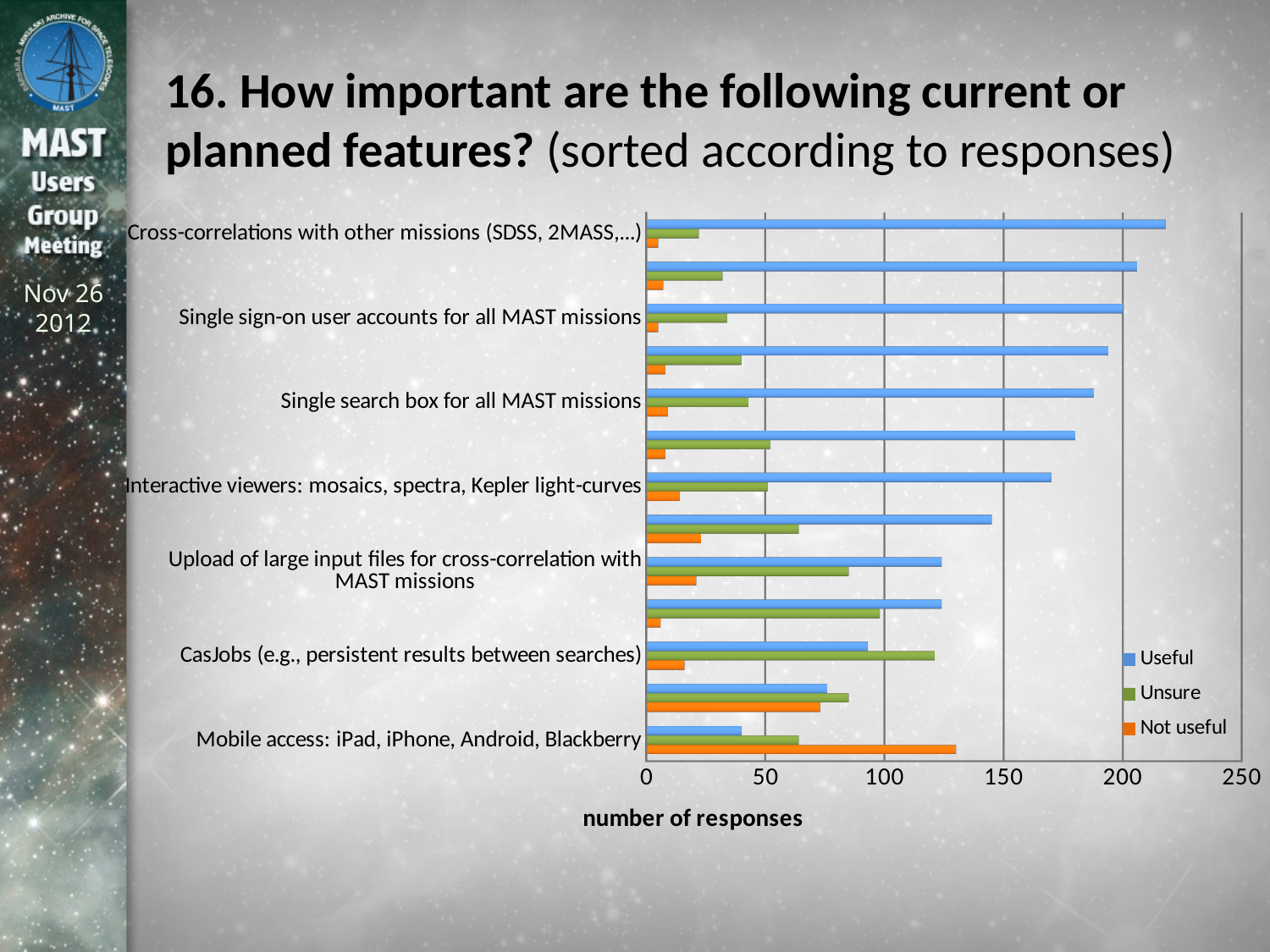
Is the 'Useful' value for Cross-correlations with other missions greater or less than 200? greater Which has more 'Useful' responses: Single search box for all MAST missions or CasJobs? Single search box for all MAST missions Is the 'Useful' value for Mobile access greater or less than 50? less What kind of chart is shown on the slide? bar chart Which labelled feature has the lowest number of 'Useful' responses? Mobile access: iPad, iPhone, Android, Blackberry Which feature has the highest number of 'Not useful' responses? Mobile access: iPad, iPhone, Android, Blackberry Which feature has the highest number of 'Useful' responses? Cross-correlations with other missions (SDSS, 2MASS,...) What is the title of the horizontal axis? number of responses How many series does the chart's legend list? 3 For Mobile access, which is larger: the 'Useful' value or the 'Not useful' value? Not useful Is the 'Useful' value for Interactive viewers greater or less than 150? greater